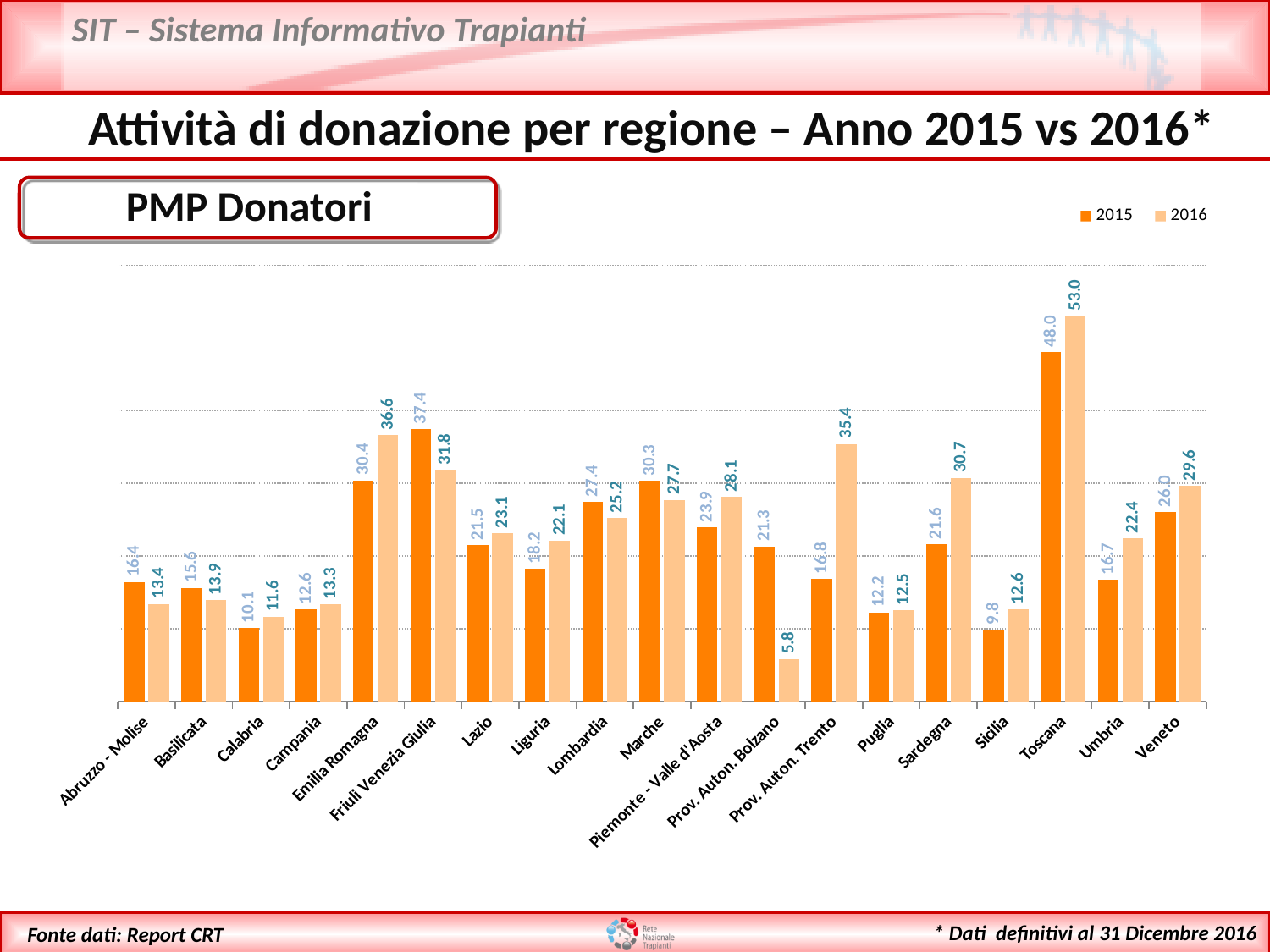
What is the 2015 value for Prov. Auton. Bolzano? 21.3 What is the PMP Donatori value for Toscana in 2016? 53.0 What is the 2016 value for Emilia Romagna? 36.6 Which region has the lowest 2015 value? Sicilia What type of chart is shown? Bar chart What is the title shown in the box above the chart? PMP Donatori Which region has the highest 2016 value? Toscana Which region has the lowest 2016 value? Prov. Auton. Bolzano How many regions are shown on the x axis? 19 Which is larger for Friuli Venezia Giulia, the 2015 value or the 2016 value? 2015 How many series does the legend list? 2 What is the difference between the 2016 and 2015 values for Prov. Auton. Trento? 18.6